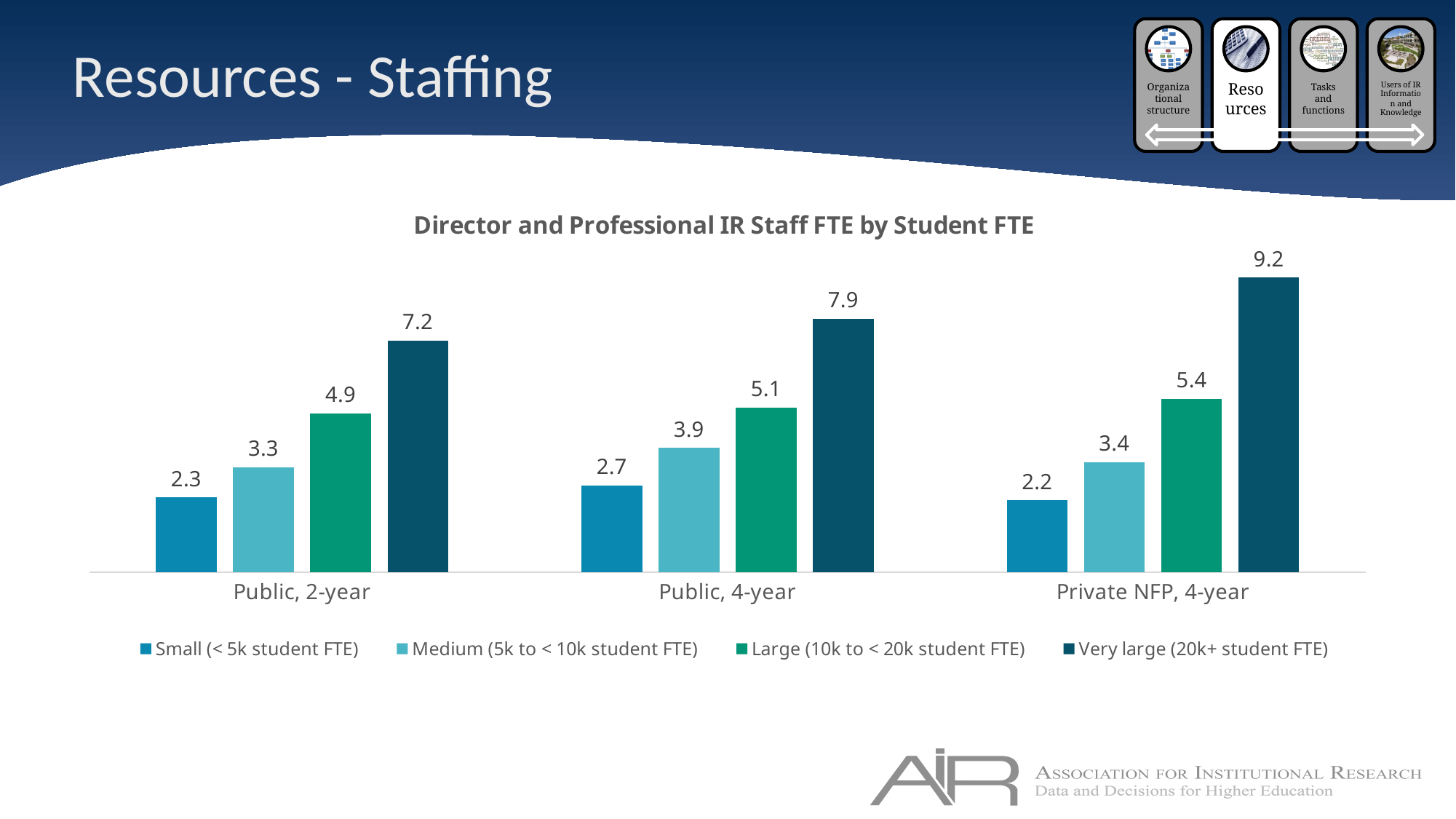
What is the value for Medium (5k to < 10k student FTE) institutions in the Public, 2-year category? 3.3 How many categories are shown on the x axis? 3 What is the value for Small (< 5k student FTE) institutions in the Public, 4-year category? 2.7 Which category has the highest value for Very large (20k+ student FTE) institutions? Private NFP, 4-year What kind of chart is shown on the slide? Bar chart What is the difference between the Very large and Small values in the Public, 2-year category? 4.9 What is the value for Very large (20k+ student FTE) institutions in the Private NFP, 4-year category? 9.2 How many series does the legend list? 4 Which category has the lowest value for Small (< 5k student FTE) institutions? Private NFP, 4-year What is the title of the chart? Director and Professional IR Staff FTE by Student FTE Which is larger: the Large (10k to < 20k student FTE) value for Public, 4-year or for Private NFP, 4-year? Private NFP, 4-year Within the Public, 4-year category, do the values rise or fall from Small to Very large institutions? Rise